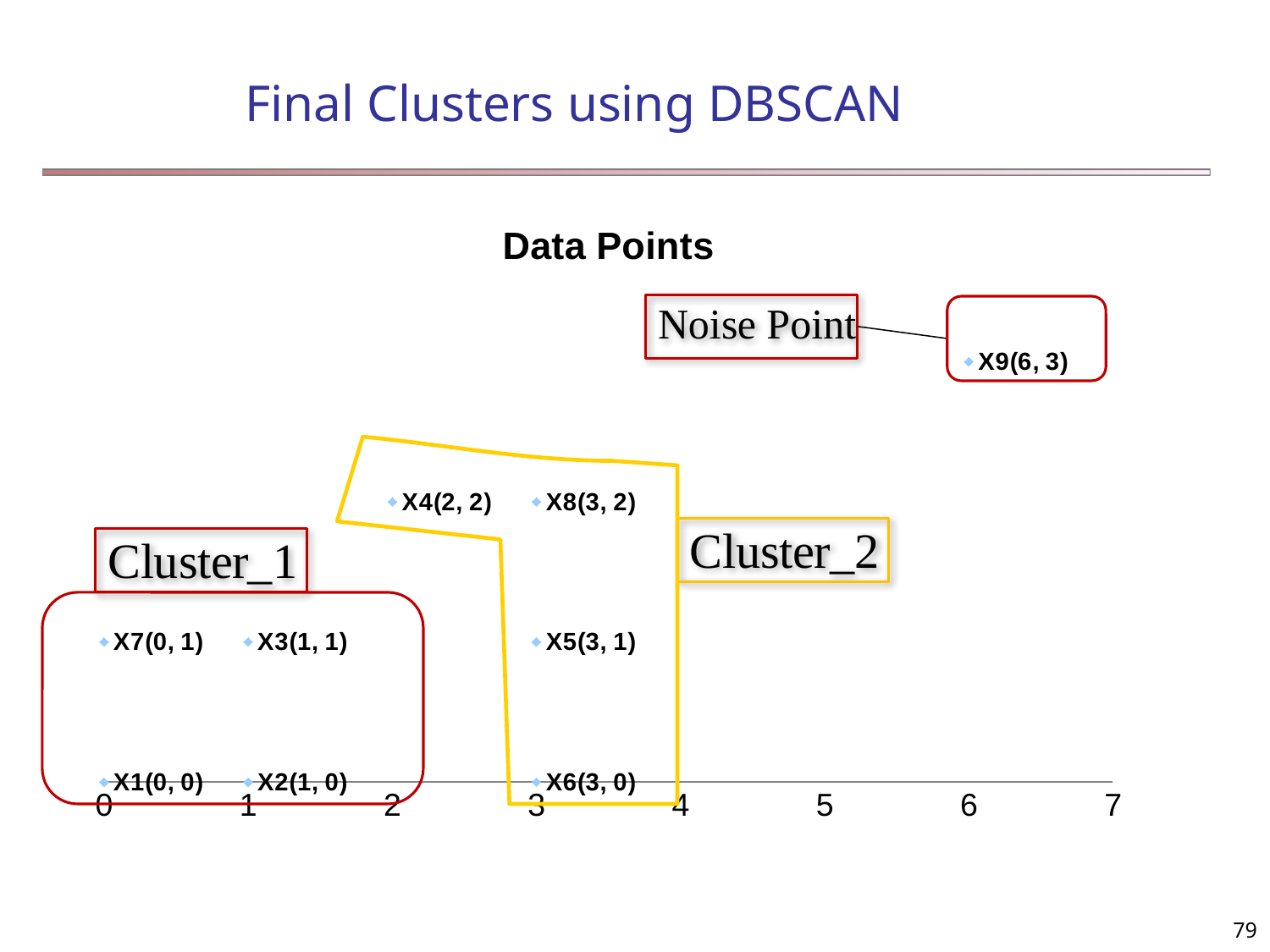
What are the coordinates of point X9? (6, 3) What kind of chart is shown on the slide? scatter chart Which data point has the largest x-coordinate? X9 Which data point is labelled as the Noise Point? X9(6, 3) What is the title of the chart? Data Points How many data points are enclosed in Cluster_2? 4 What are the coordinates of point X4? (2, 2) What is the difference between the x-coordinate of X9 and the x-coordinate of X8? 3 How many data points are enclosed in Cluster_1? 4 Which point has a larger y-coordinate, X4 or X5? X4 How many data points are plotted in the chart? 9 What are the coordinates of point X5? (3, 1)